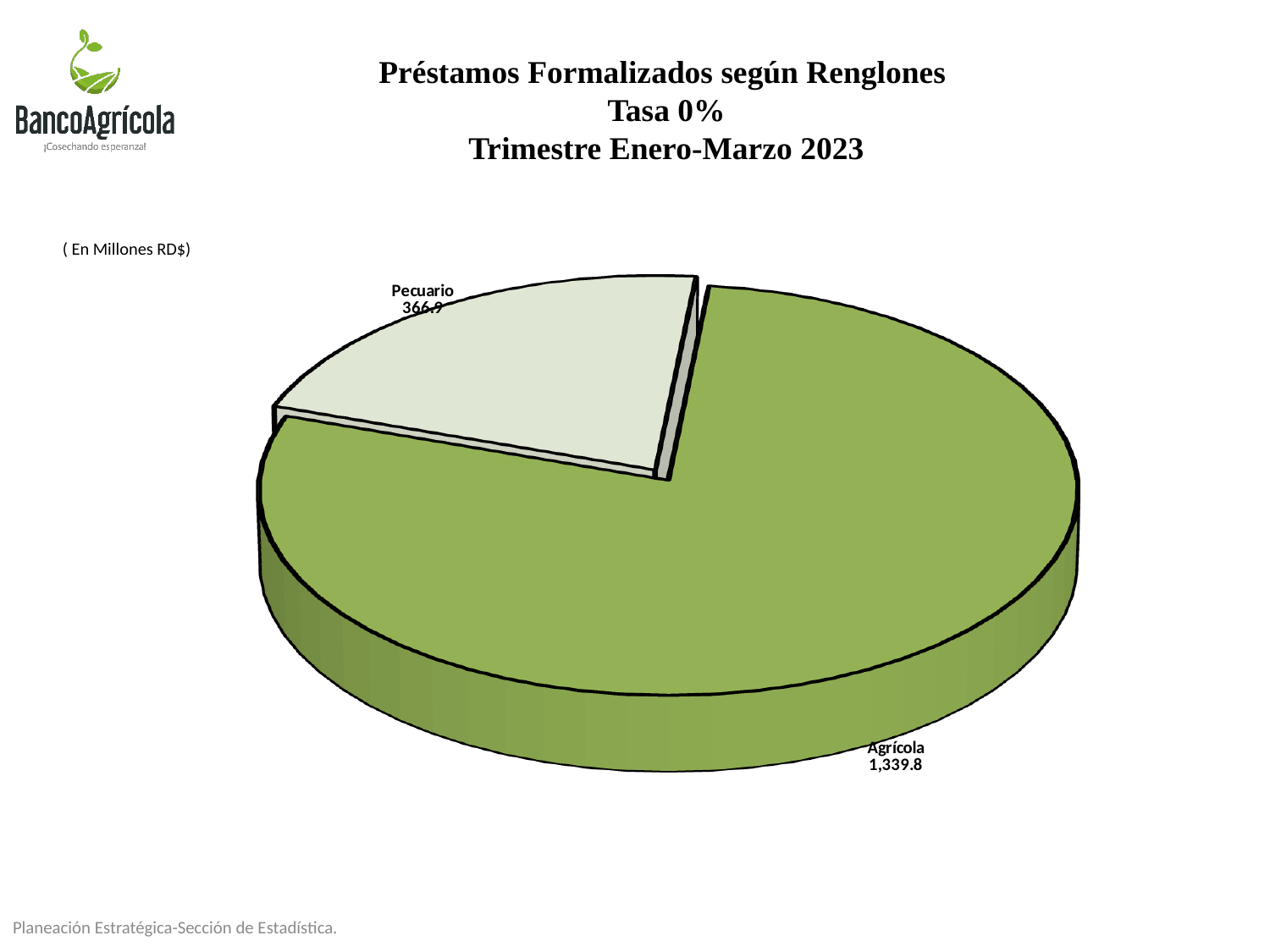
Which category has the largest slice of the pie chart? Agrícola In what units are the values in the chart expressed? En Millones RD$ What is the difference between the Agrícola value and the Pecuario value? 972.9 Which quarter does the chart title say the data covers? Trimestre Enero-Marzo 2023 What kind of chart is shown on the slide? Pie chart What is the value for Agrícola in the pie chart? 1,339.8 How many categories are shown in the pie chart? 2 What is the total of the two values shown in the pie chart? 1,706.7 Which is larger, the value for Agrícola or the value for Pecuario? Agrícola What is the value for Pecuario in the pie chart? 366.9 Which category has the smallest slice of the pie chart? Pecuario